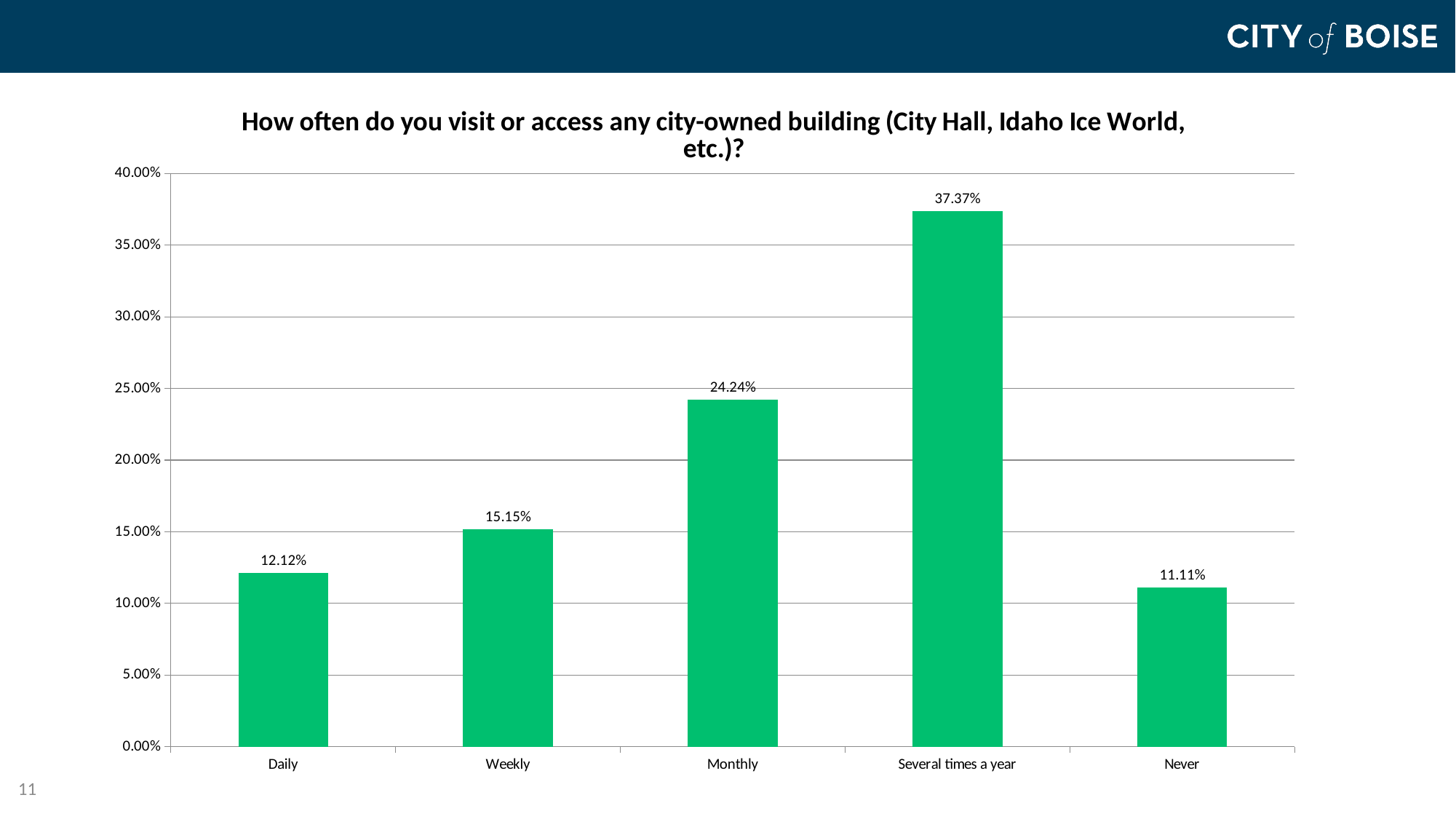
What is the value for Never? 11.11% What is the difference between the highest and lowest values? 26.26% How many categories are shown on the x axis? 5 Which is larger, the value for Daily or the value for Weekly? Weekly What is the maximum value shown on the y axis? 40.00% What percentage of respondents visit a city-owned building daily? 12.12% Which category has the lowest value? Never What is the value for Several times a year? 37.37% What kind of chart is shown on the slide? Bar chart Which category has the highest value? Several times a year Is the value for Monthly greater or less than 25.00%? less What is the difference between the Monthly and Weekly values? 9.09%